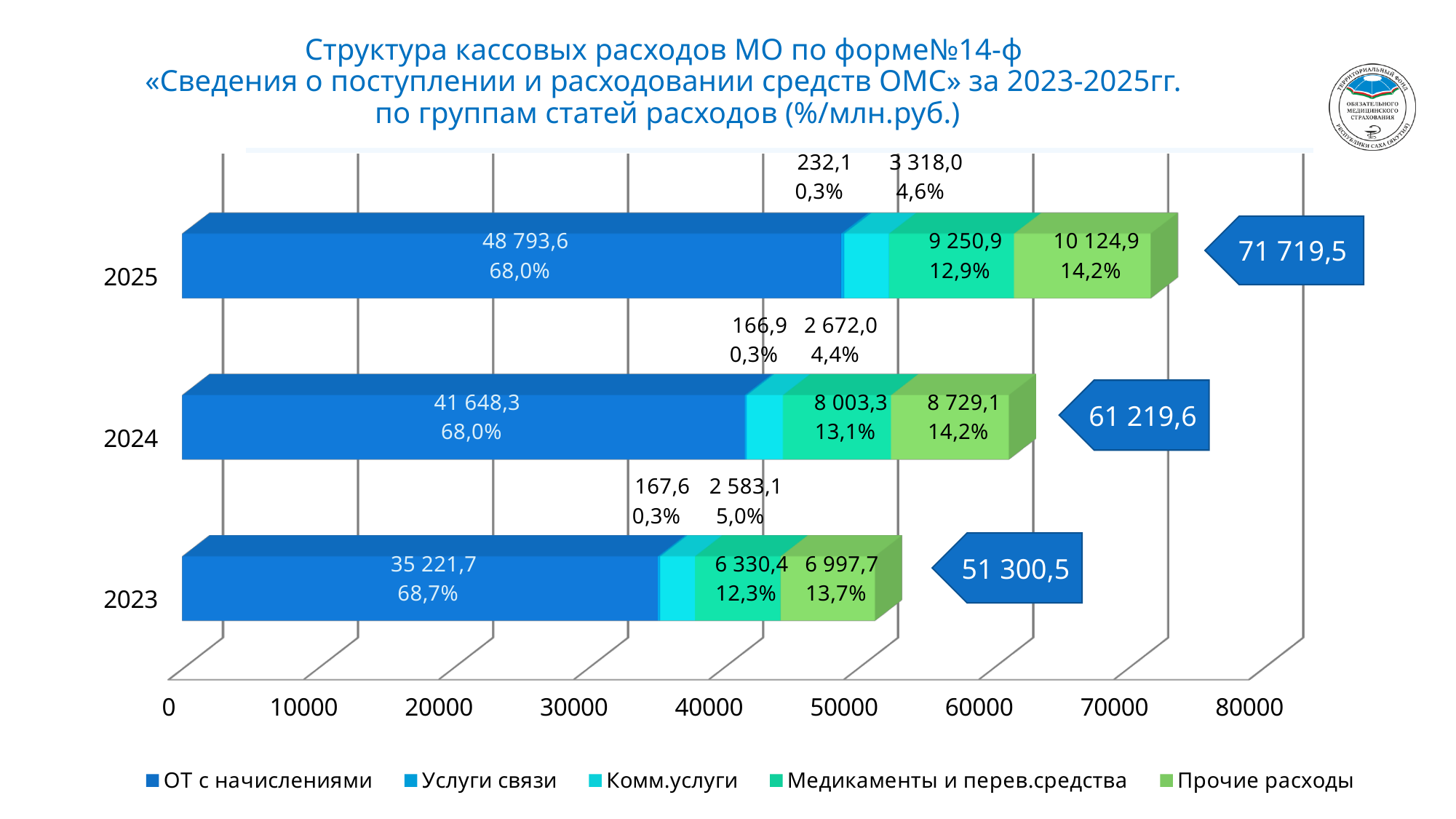
How many series does the legend list? 5 What is the total of the stacked bar for 2025? 71 719,5 What is the value of Комм.услуги for 2024? 2 672,0 Which year has the lowest total expenditure? 2023 What is the difference between Прочие расходы in 2025 and in 2024? 1 395,8 In 2025, which is larger: Медикаменты и перев.средства or Прочие расходы? Прочие расходы What share of the 2023 total is ОТ с начислениями? 68,7% Which year has the highest total expenditure? 2025 What is the value of Медикаменты и перев.средства for 2023? 6 330,4 How many years (categories) are shown on the chart? 3 What is the value of Прочие расходы for 2024? 8 729,1 What is the value of ОТ с начислениями for 2025? 48 793,6